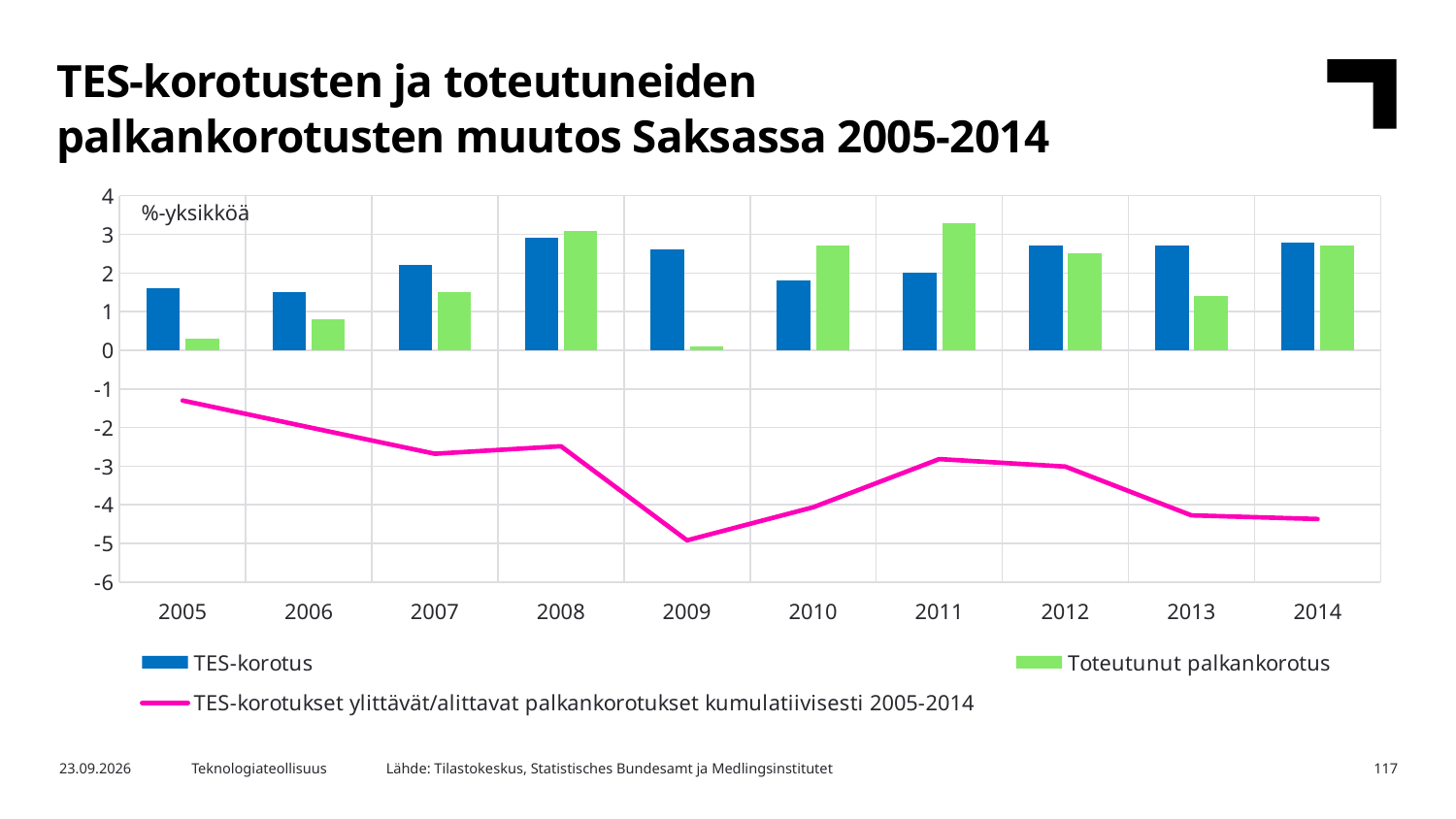
What unit label is shown in the top-left corner of the plot area? %-yksikköä Is the Toteutunut palkankorotus value for 2009 greater or less than 1? less In 2011, which is larger: the TES-korotus bar or the Toteutunut palkankorotus bar? Toteutunut palkankorotus In which year is the Toteutunut palkankorotus bar the lowest? 2009 What kind of chart is shown on the slide? A combined bar and line chart Does the pink cumulative line rise or fall from 2005 to 2009? fall Is the TES-korotus value for 2008 greater or less than 2? greater In 2009, which is larger: the TES-korotus bar or the Toteutunut palkankorotus bar? TES-korotus How many years are shown on the x axis of the chart? 10 How many series does the chart's legend list? 3 In which year does the pink cumulative line reach its lowest point? 2009 Is the value of the pink cumulative line in 2009 greater or less than -4? less